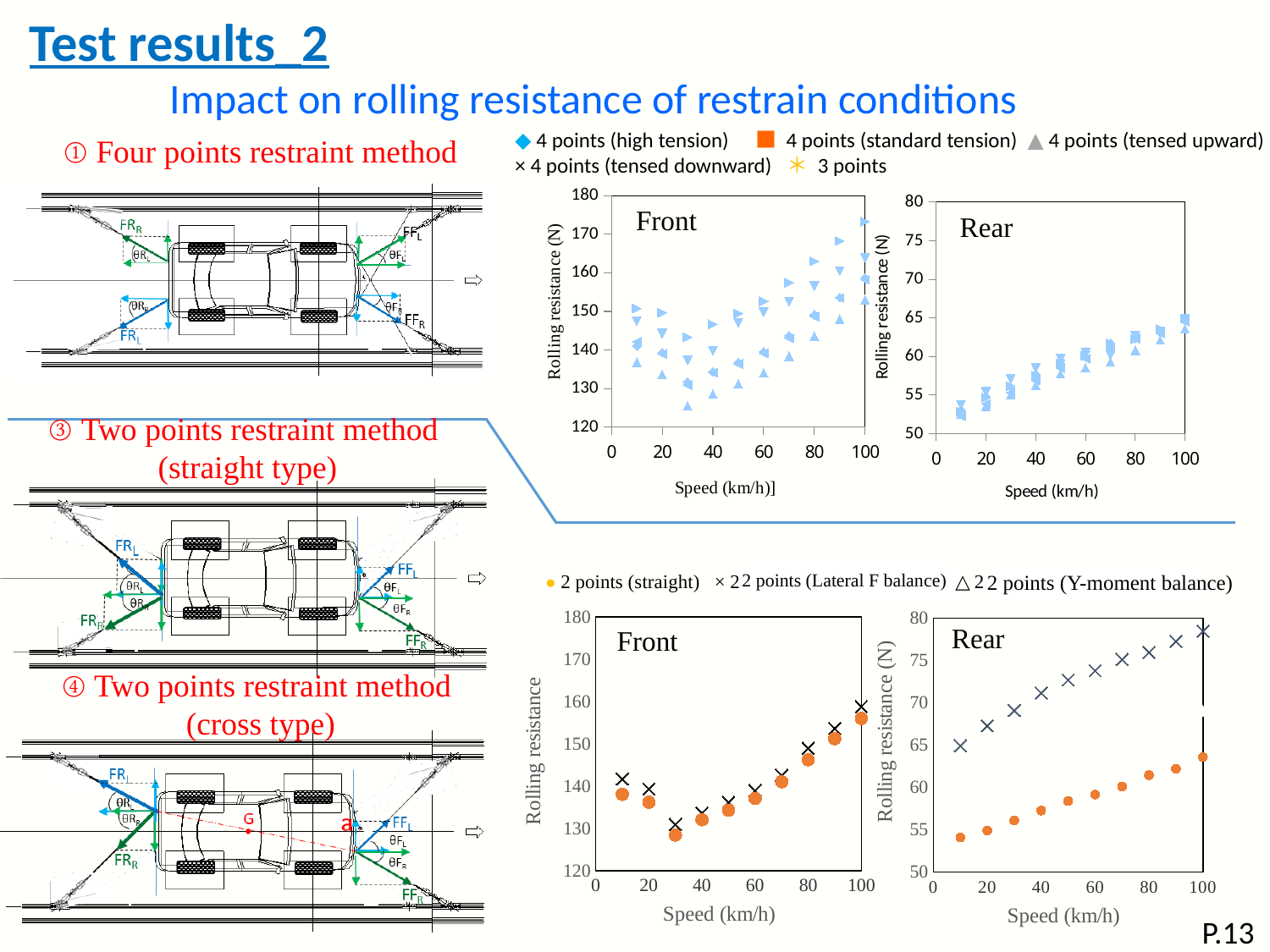
In the bottom-right 'Rear' chart, is the value for '2 points (straight)' at 10 km/h greater or less than 60? less What is the x-axis label of the bottom-left 'Front' chart? Speed (km/h) In the bottom-left 'Front' chart, is the value for '2 points (straight)' at 30 km/h greater or less than 140? less In the bottom-right 'Rear' chart, is the value for '2 points (Lateral F balance)' at 100 km/h greater or less than 75? greater In the top-right 'Rear' chart, do the rolling resistance values generally rise or fall as speed increases? rise In the bottom-right 'Rear' chart, do the values for '2 points (straight)' rise or fall as speed increases? rise How many series does the legend above the top pair of charts list? 5 What kind of chart is the bottom-right 'Rear' chart? scatter chart In the bottom-right 'Rear' chart, at 100 km/h, which series has the larger value: '2 points (straight)' or '2 points (Lateral F balance)'? 2 points (Lateral F balance) How many series does the legend above the bottom pair of charts list? 3